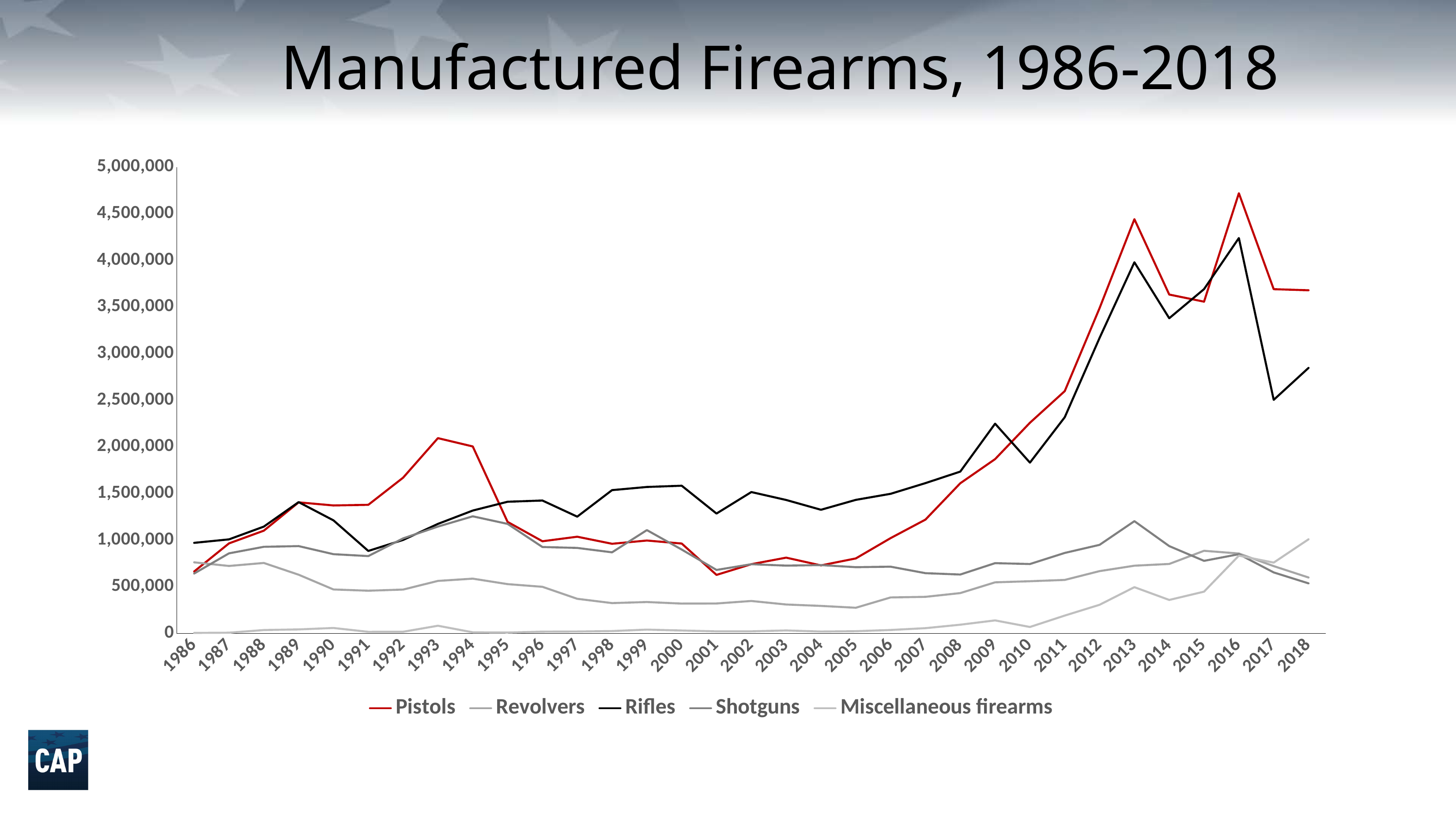
Is the value for Pistols in 2001 greater or less than 1,000,000? less Which series has the highest value in 2016? Pistols What kind of chart is shown on the slide? line chart Is the value for Pistols in 2016 greater or less than 4,500,000? greater Is the value for Rifles in 2017 greater or less than 3,000,000? less How many years are shown along the x axis? 33 How many series does the legend list? 5 In 2009, which is larger: Rifles or Pistols? Rifles In 1993, which is larger: Pistols or Rifles? Pistols Do the values for Pistols rise or fall from 2005 to 2013? rise Which series has the lowest value in 2010? Miscellaneous firearms